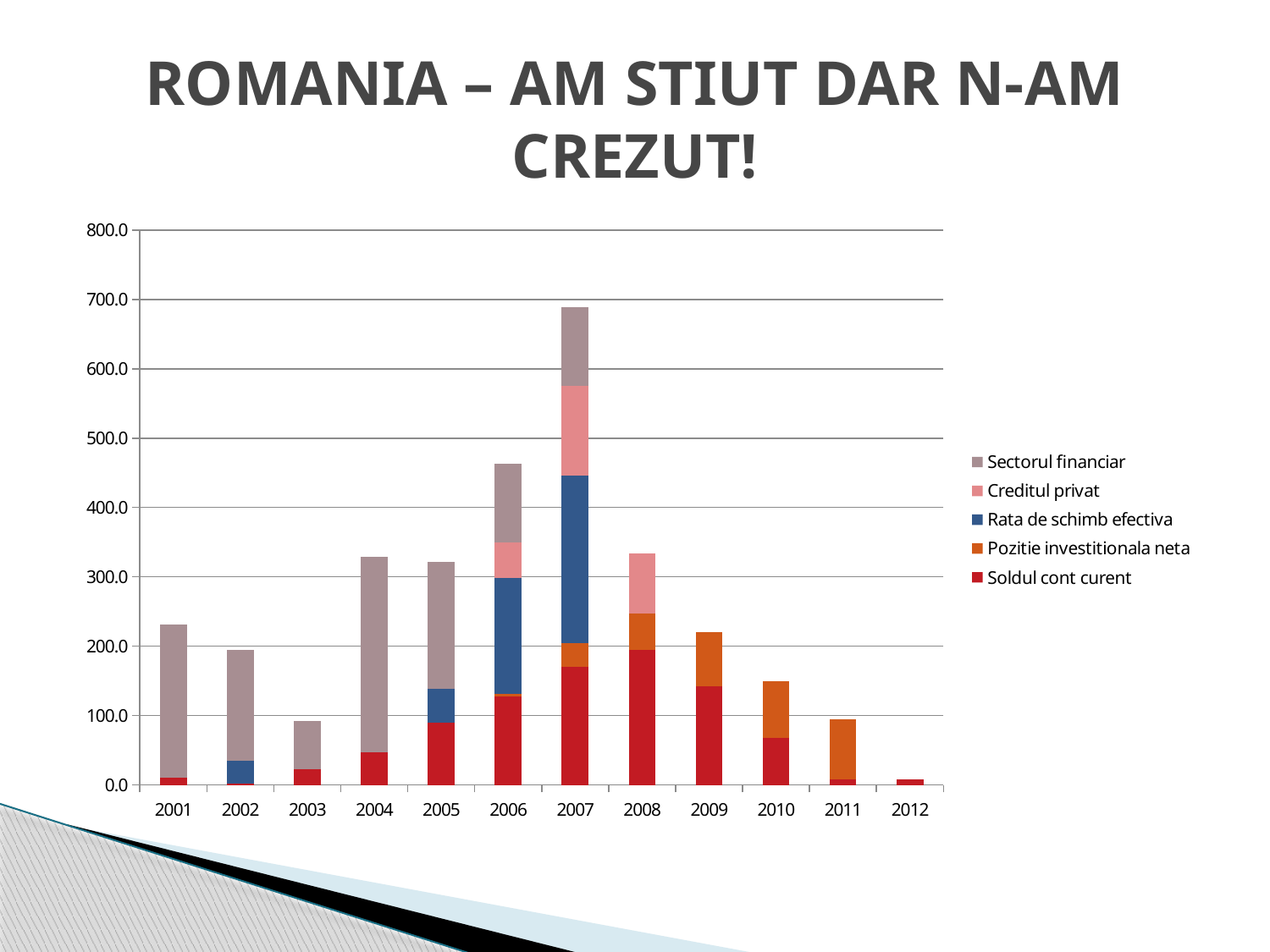
Which year has the larger total stacked bar, 2009 or 2010? 2009 Is the total stacked value for 2007 greater or less than 600? greater Which year has the shortest stacked bar? 2012 Which year has the larger total stacked bar, 2003 or 2004? 2004 Which year has the tallest stacked bar? 2007 Is the total stacked value for 2006 greater or less than 400? greater How many series does the chart's legend list? 5 Do the total stacked values rise or fall from 2007 to 2012? fall Which series is shown at the bottom of each stacked bar? Soldul cont curent How many years are shown on the x axis of the chart? 12 What kind of chart is shown on the slide? Stacked bar chart Is the total stacked value for 2003 greater or less than 100? less